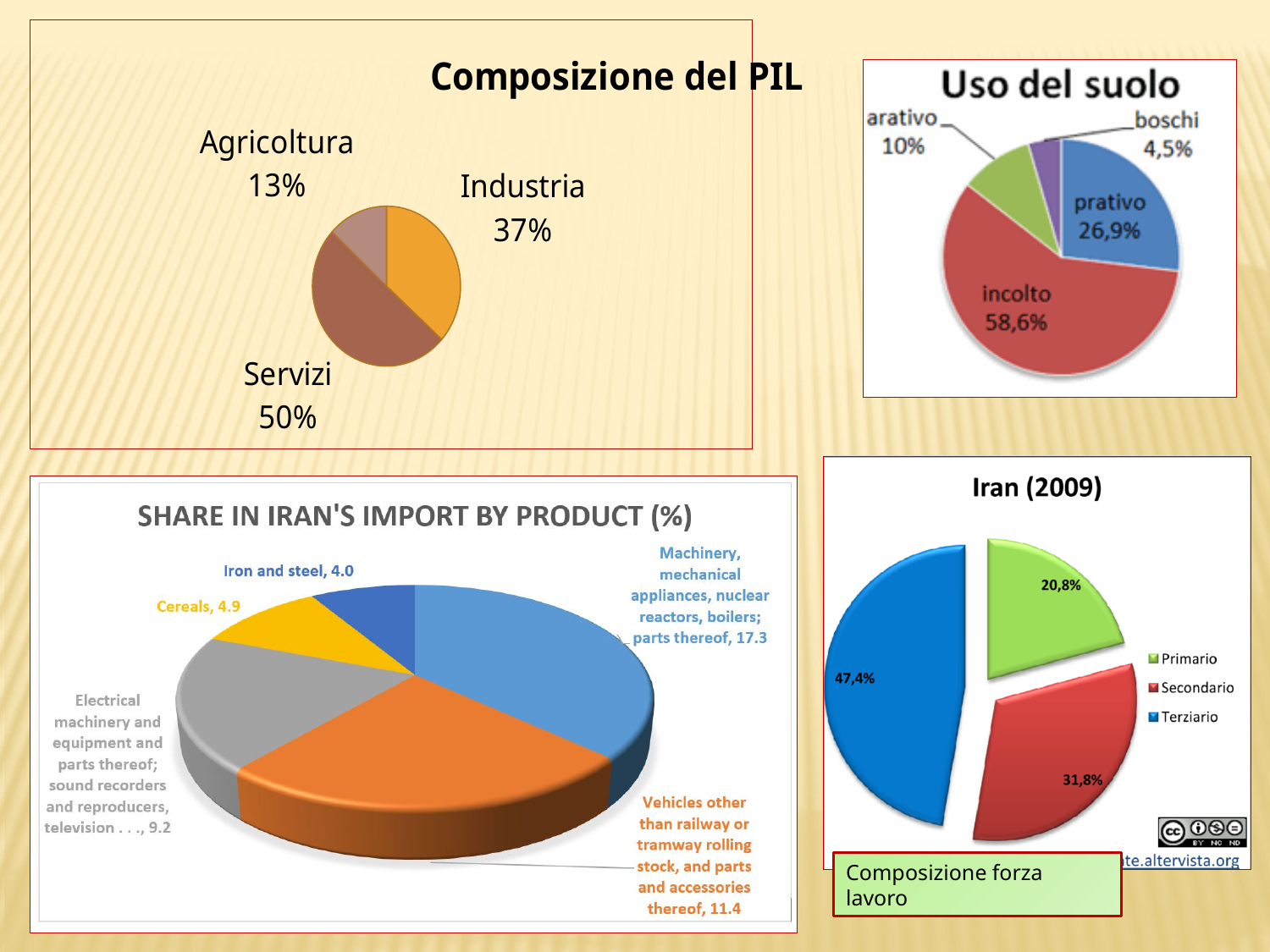
What kind of chart is the 'Iran (2009)' chart? Pie chart In the 'Composizione del PIL' chart, what is the value for Servizi? 50% In the 'Composizione del PIL' chart, which category has the smallest share? Agricoltura In the 'Iran (2009)' chart, what is the value for Secondario? 31,8% In the 'Composizione del PIL' chart, what is the difference between Industria and Agricoltura? 24% In the 'Iran (2009)' chart, how many series does the legend list? 3 In the 'Uso del suolo' chart, which category has the largest share? incolto In the 'Uso del suolo' chart, what is the value for prativo? 26,9% In the 'Uso del suolo' chart, how many categories are shown? 4 In the 'Share in Iran's import by product (%)' chart, what is the value for Cereals? 4.9 In the 'Share in Iran's import by product (%)' chart, which is larger: Iron and steel or Cereals? Cereals In the 'Share in Iran's import by product (%)' chart, what is the value for Vehicles other than railway or tramway rolling stock, and parts and accessories thereof? 11.4